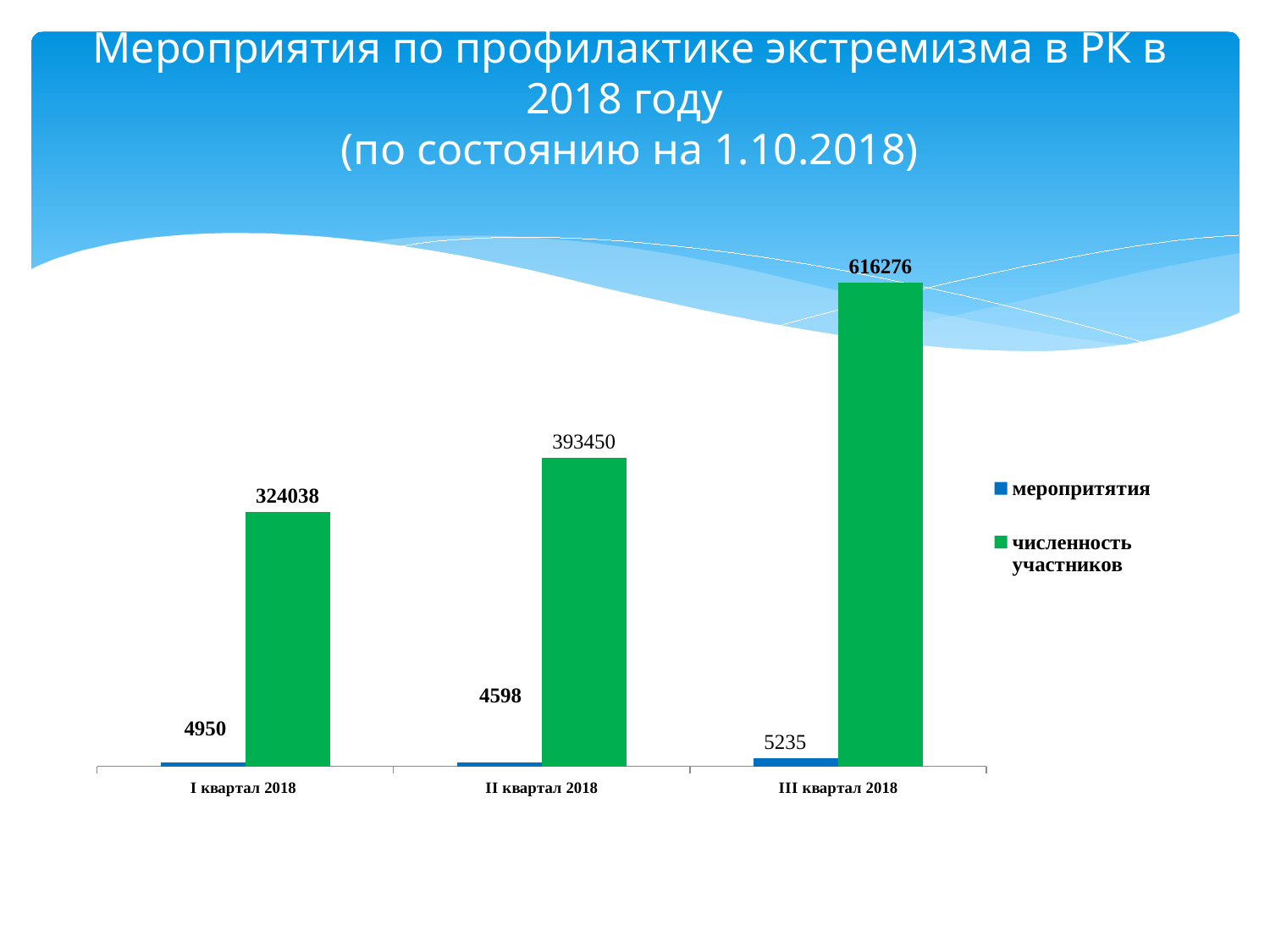
What is the difference in численность участников between III квартал 2018 and II квартал 2018? 222826 What is the value of мероприятия for III квартал 2018? 5235 How many series does the legend list? 2 Which quarter has the highest численность участников? III квартал 2018 What kind of chart is shown on the slide? bar chart What is the value of численность участников for III квартал 2018? 616276 Which is larger: численность участников for II квартал 2018 or for I квартал 2018? II квартал 2018 What is the difference in мероприятия between I квартал 2018 and II квартал 2018? 352 How many quarters are shown on the x axis? 3 What is the value of численность участников for I квартал 2018? 324038 What is the value of мероприятия for II квартал 2018? 4598 Which quarter has the lowest value for мероприятия? II квартал 2018